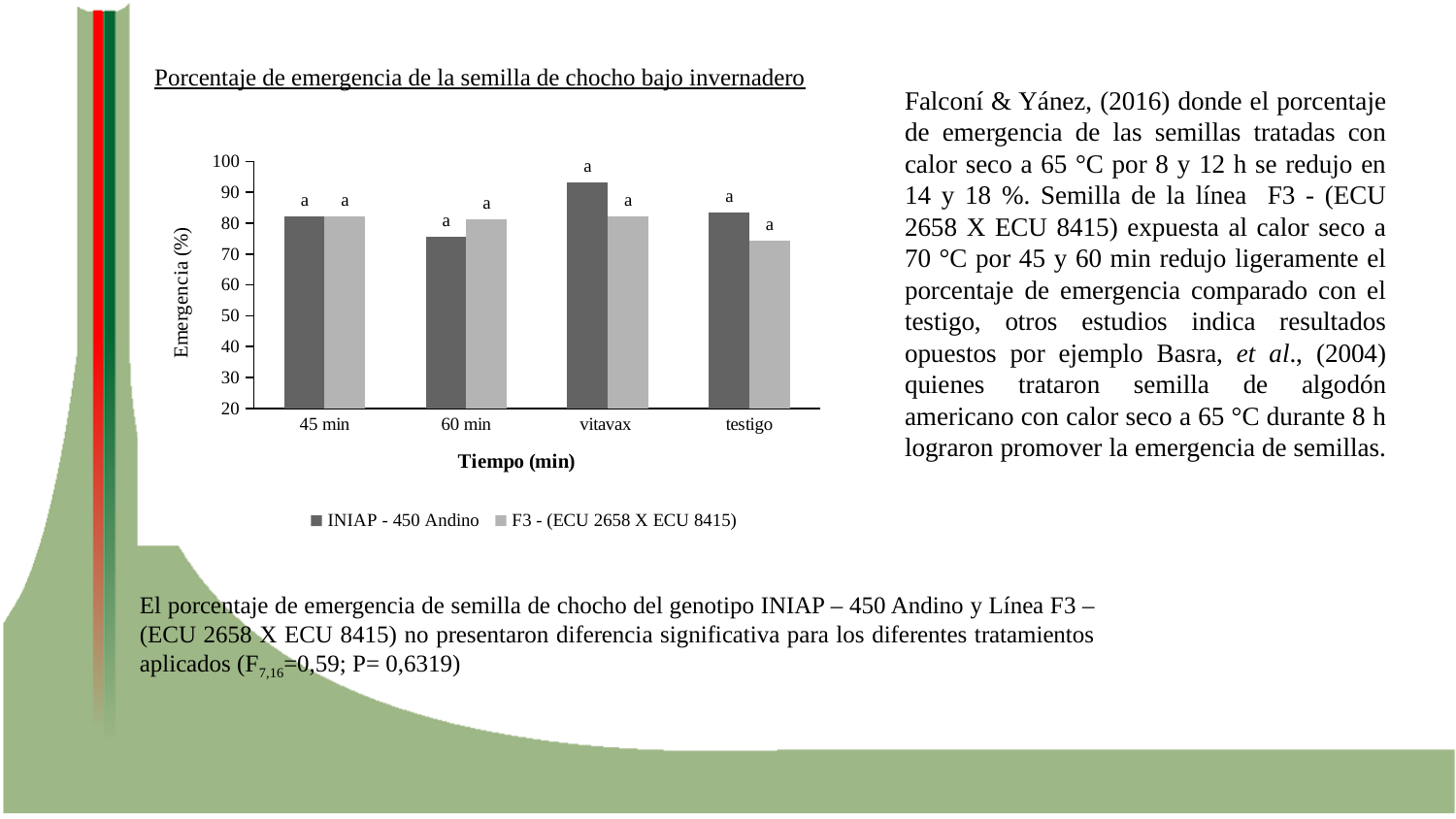
At vitavax, which series has the larger value, INIAP - 450 Andino or F3 - (ECU 2658 X ECU 8415)? INIAP - 450 Andino Is the value for F3 - (ECU 2658 X ECU 8415) at 45 min greater or less than 80? greater How many series does the chart legend list? 2 What kind of chart is shown on the slide? bar chart What is the title of the y axis of the chart? Emergencia (%) At 60 min, which series has the larger value, INIAP - 450 Andino or F3 - (ECU 2658 X ECU 8415)? F3 - (ECU 2658 X ECU 8415) Which category has the highest bar for INIAP - 450 Andino? vitavax How many categories are shown on the x axis of the chart? 4 What is the title of the x axis of the chart? Tiempo (min) Is the value for F3 - (ECU 2658 X ECU 8415) at testigo greater or less than 80? less Is the value for INIAP - 450 Andino at 60 min greater or less than 80? less